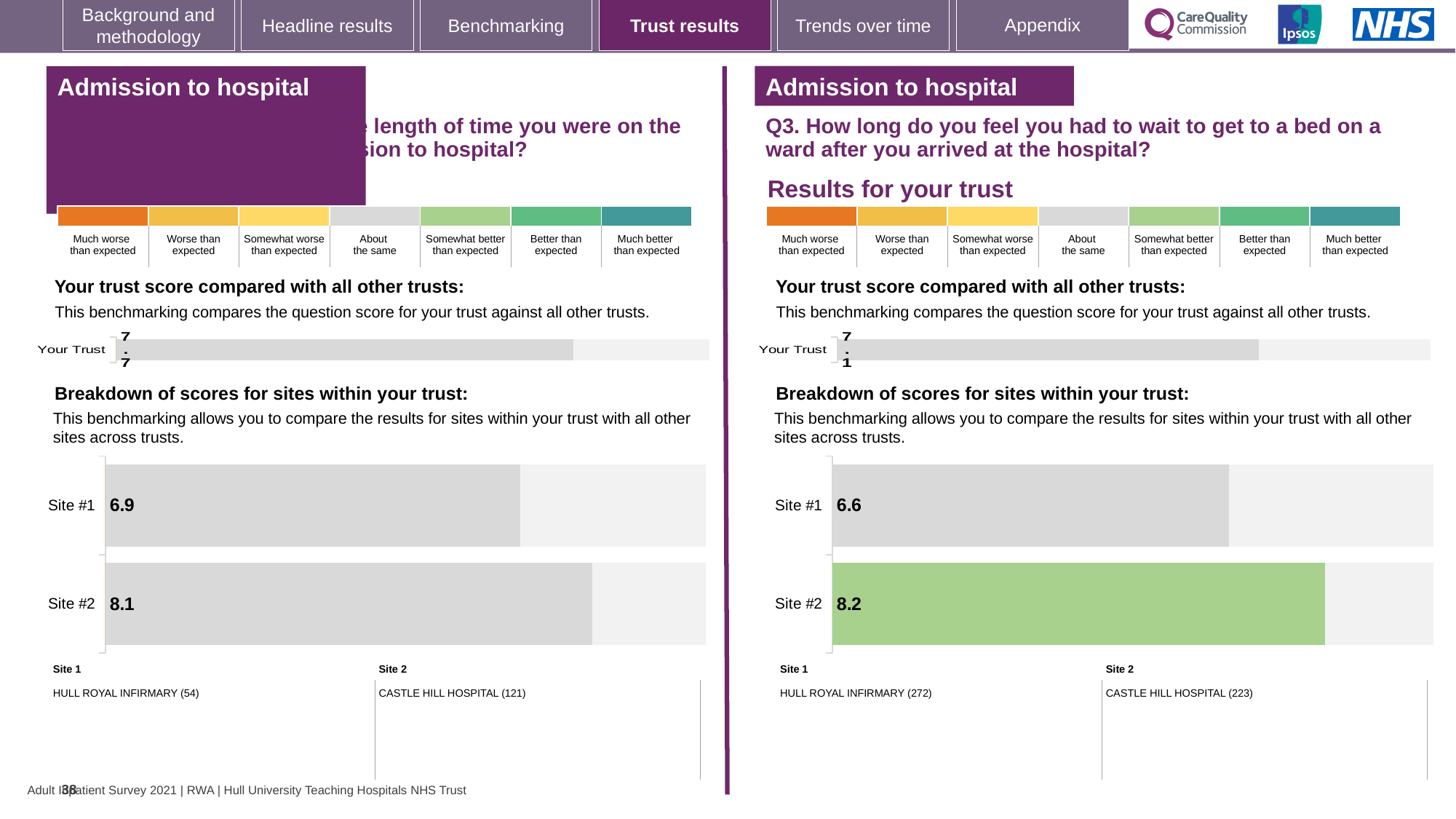
On the left-hand chart, which site has the lowest score? Site #1 On the right-hand chart (Q3, wait to get to a bed on a ward), what is the score for Site #2? 8.2 On the left-hand chart, what is the score for Site #2? 8.1 On the right-hand chart (Q3), which site has the higher score, Site #1 or Site #2? Site #2 What type of chart is used for the breakdown of scores for sites on the right-hand side (Q3)? Bar chart On the right-hand chart (Q3), what is the difference between the Site #2 and Site #1 scores? 1.6 On the left-hand chart, what is the difference between the Site #2 and Site #1 scores? 1.2 On the right-hand chart (Q3, wait to get to a bed on a ward), what is the score for Site #1? 6.6 How many sites are shown in the site breakdown chart on the right-hand side (Q3)? 2 On the right-hand chart (Q3), what is the score shown for Your Trust? 7.1 On the left-hand chart, what is the score for Site #1? 6.9 On the left-hand chart, what is the score shown for Your Trust? 7.7